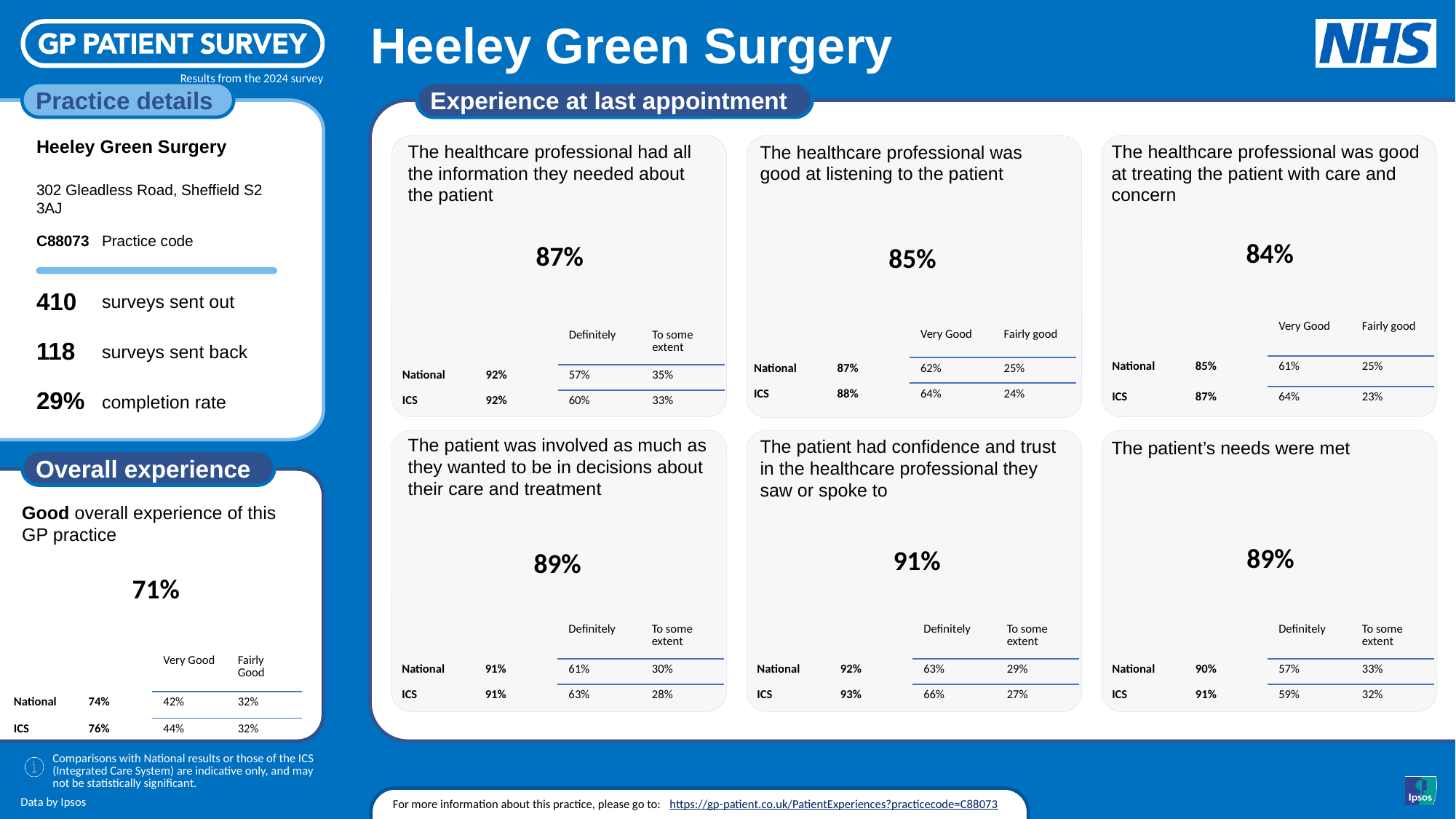
In the 'Overall experience' panel, what percentage of patients reported a good overall experience of this GP practice? 71% In the 'Overall experience' panel, what is the National figure for good overall experience? 74% How many statement panels are shown in the 'Experience at last appointment' section? 6 In the 'Experience at last appointment' section, what is the practice's percentage for 'The patient had confidence and trust in the healthcare professional they saw or spoke to'? 91% In the panel 'The patient's needs were met', which is larger: the National figure or the ICS figure? ICS In the 'Overall experience' panel, what is the ICS 'Very Good' percentage? 44% In the 'Experience at last appointment' section, which of the six statements has the highest practice percentage? The patient had confidence and trust in the healthcare professional they saw or spoke to In the panel 'The healthcare professional had all the information they needed about the patient', what is the difference between the National figure and the practice figure? 5% In the panel 'The healthcare professional was good at treating the patient with care and concern', what is the ICS 'Very Good' percentage? 64% In the 'Overall experience' panel, what is the difference between the ICS figure and the practice figure for good overall experience? 5% In the 'Experience at last appointment' section, which of the six statements has the lowest practice percentage? The healthcare professional was good at treating the patient with care and concern In the 'Experience at last appointment' section, what is the practice's percentage for 'The healthcare professional was good at listening to the patient'? 85%